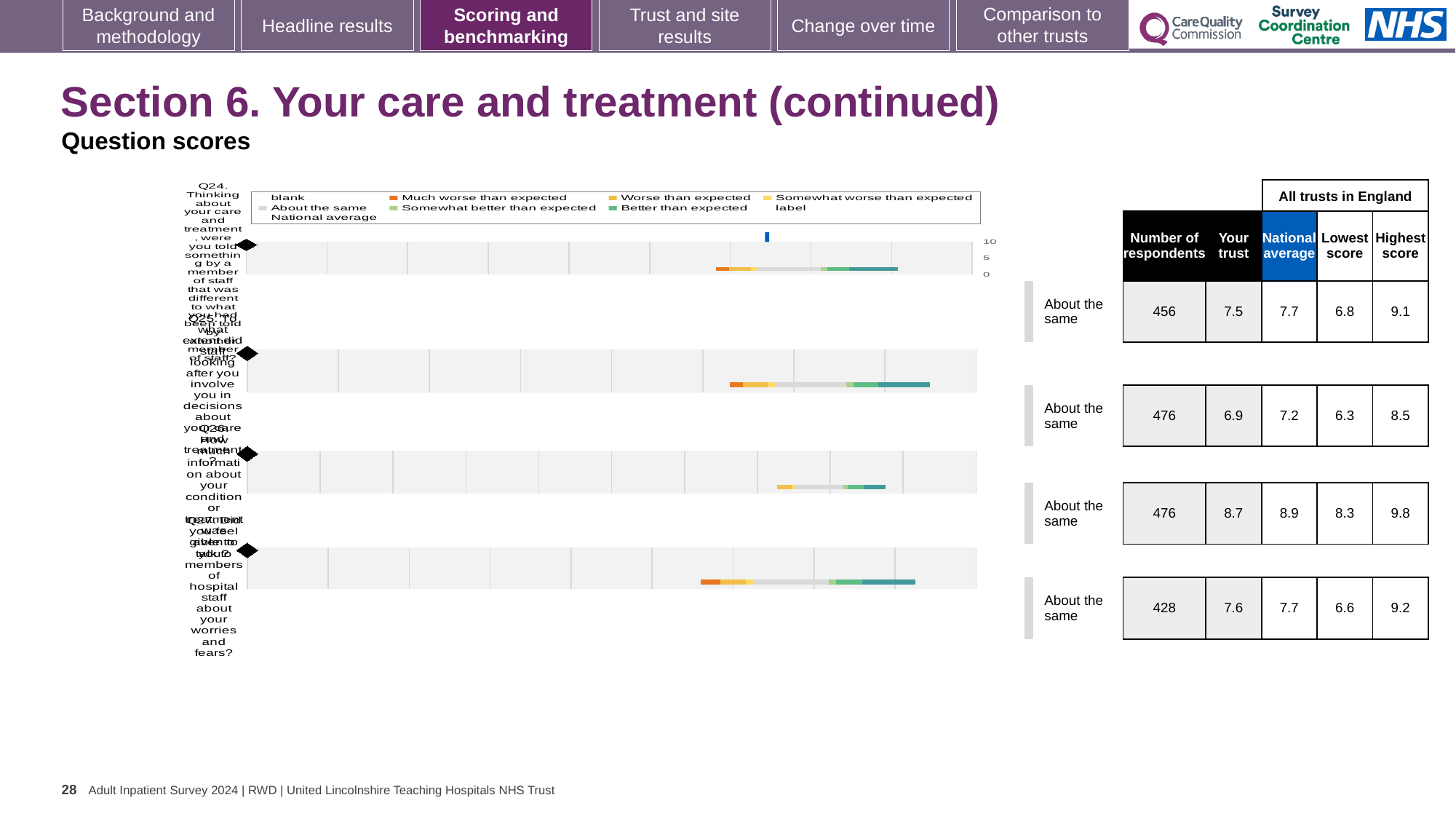
For the third question row (Q26), which is larger: the trust score or the national average? National average (8.9) What is the national average for the second question row (Q25)? 7.2 What kind of chart is used to show the question scores on this slide? bar chart What is the highest score across all trusts in England for the third question row (Q26)? 9.8 How many respondents answered the fourth question row (Q27)? 428 Which question row has the highest 'Your trust' score? Q26 (third row), 8.7 Which legend entry is shown in dark orange? Much worse than expected How many question rows (bars) are plotted in the chart? 4 What benchmark category is shown for every question row on this slide? About the same For the first question row (Q24), what is the difference between the national average and the trust score? 0.2 What is the 'Your trust' score for the first question row (Q24)? 7.5 Which question row has the lowest 'Your trust' score? Q25 (second row), 6.9